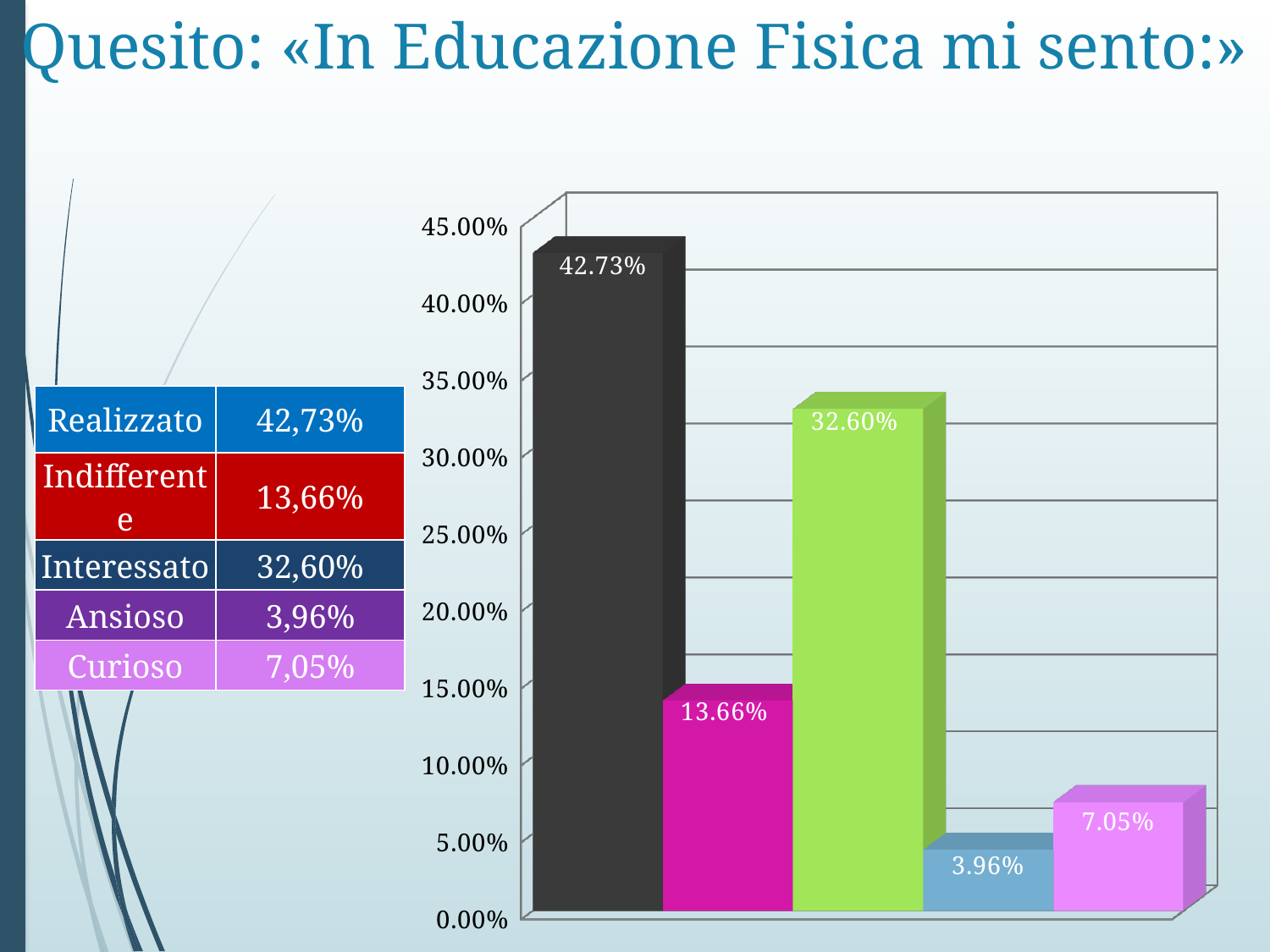
What value is labelled on the tallest bar in the chart? 42.73% What is the data label on the green bar in the chart? 32.60% Which is larger: the value on the magenta bar or the value on the pink rightmost bar? the magenta bar (13.66%) What value is labelled on the shortest bar in the chart? 3.96% What is the data label on the second bar from the left (the magenta bar)? 13.66% What kind of chart is shown on the slide? bar chart How many bars are plotted in the chart? 5 What is the difference between the values labelled on the first bar (42.73%) and the third bar (32.60%)? 10.13% What is the highest value shown on the vertical axis of the chart? 45.00% According to the table, which response corresponds to the value 32,60%? Interessato What is the data label on the rightmost bar in the chart? 7.05% Is the value on the light blue bar greater or less than 5.00%? less